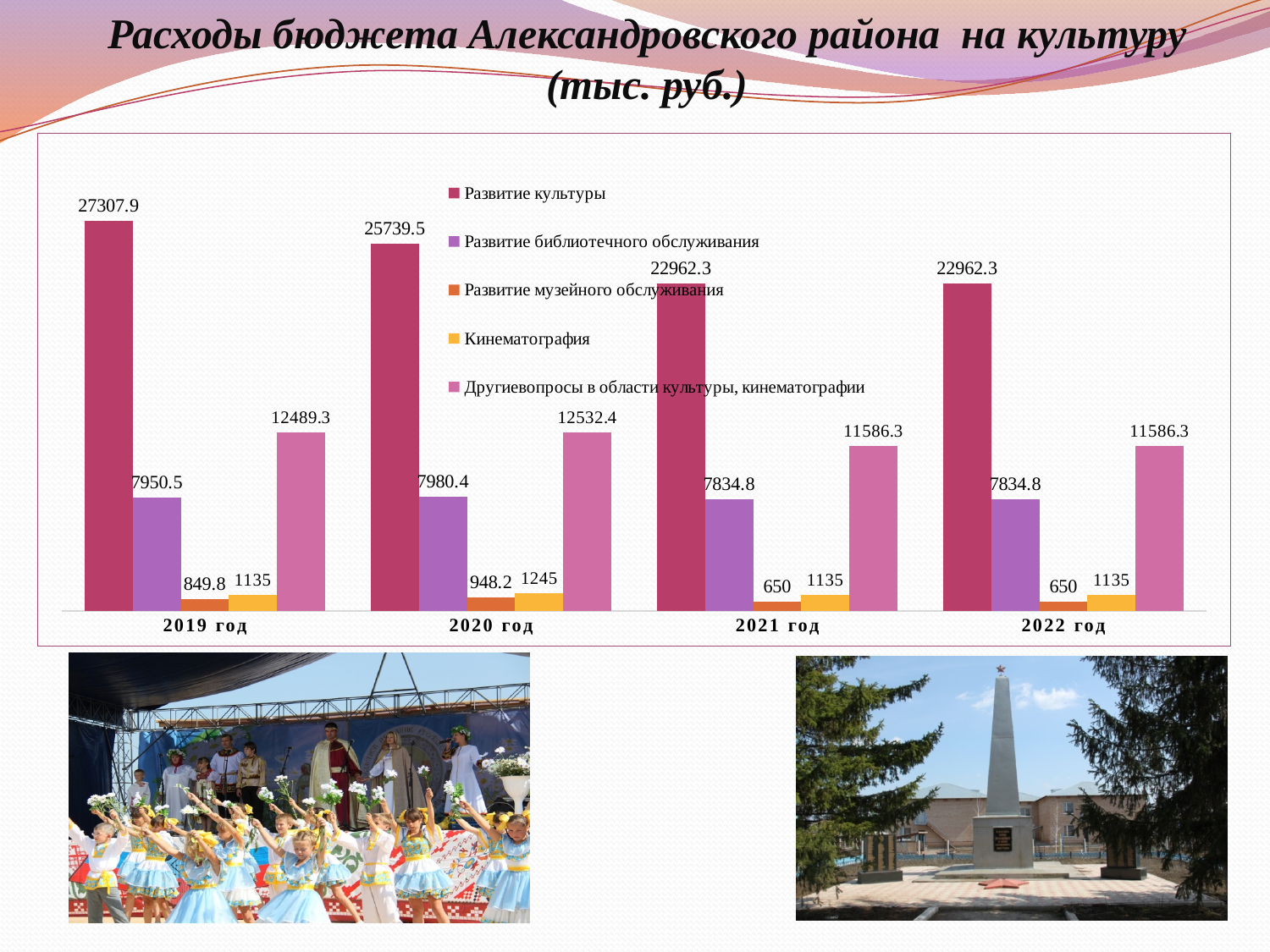
What is the value for Развитие библиотечного обслуживания in 2020 год? 7980.4 In which year is the value for Развитие музейного обслуживания the lowest? 2021 год and 2022 год What is the value for Другие вопросы в области культуры, кинематографии in 2022 год? 11586.3 What is the difference between the Развитие культуры values for 2019 год and 2020 год? 1568.4 Which is larger: Другие вопросы в области культуры, кинематографии in 2020 год or in 2021 год? 2020 год In which year is the value for Развитие культуры the highest? 2019 год What is the value for Кинематография in 2020 год? 1245 What is the value for Развитие культуры in 2019 год? 27307.9 What is the value for Развитие музейного обслуживания in 2021 год? 650 What kind of chart is shown on the slide? Bar chart How many year categories are shown on the x axis? 4 How many series does the legend list? 5